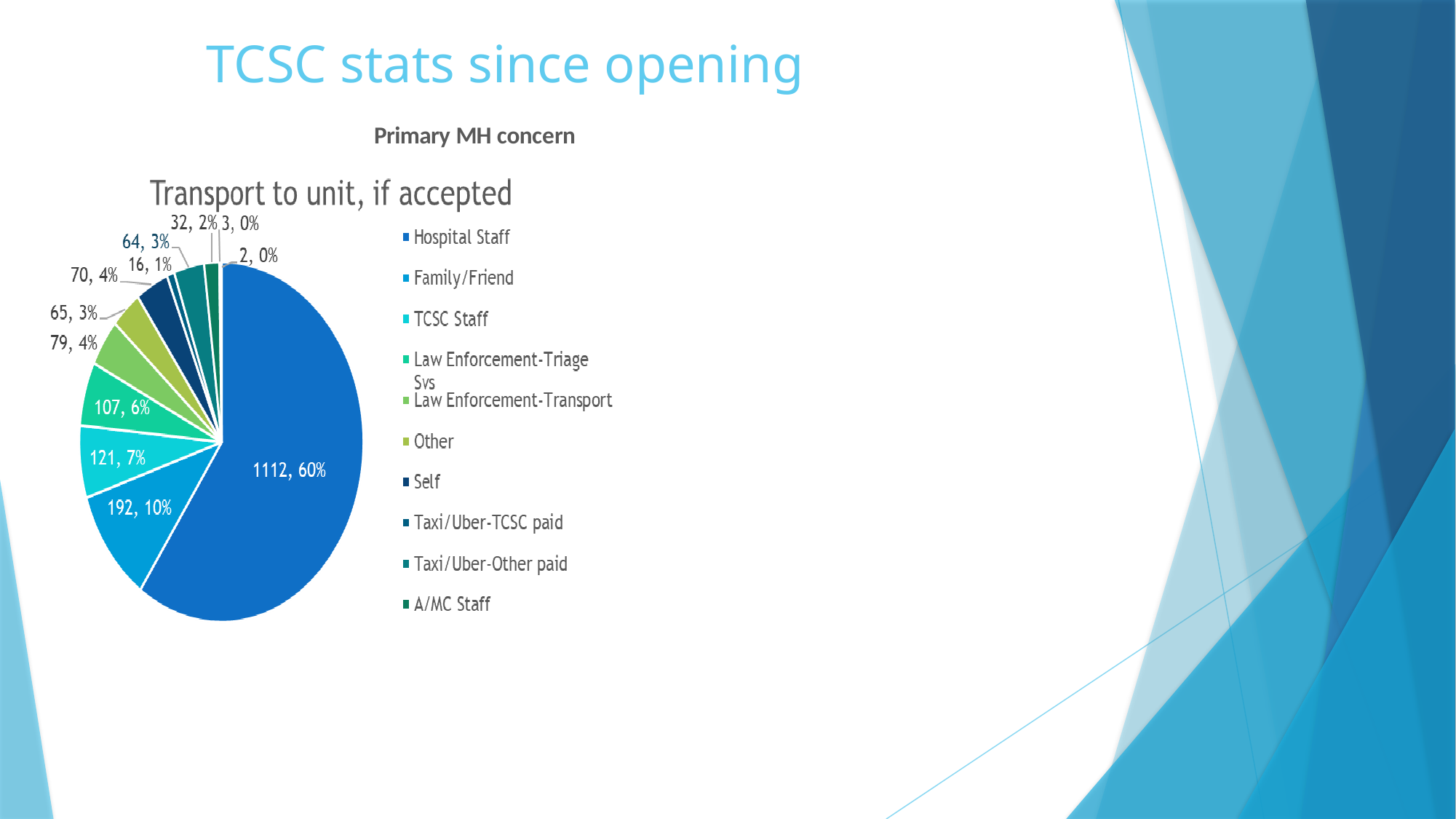
What is the value shown for Family/Friend in the pie chart? 192 Which is larger in the pie chart, Family/Friend or TCSC Staff? Family/Friend What is the difference between the Family/Friend value and the TCSC Staff value? 71 How many entries does the legend of the pie chart list? 10 What share of the pie does Hospital Staff account for? 60% What is the difference between the Hospital Staff value and the Family/Friend value? 920 What is the value shown for Hospital Staff in the pie chart? 1112 What is the value shown for TCSC Staff in the pie chart? 121 What is the title of the pie chart? Transport to unit, if accepted What kind of chart is shown on the slide? pie chart What share of the pie does Family/Friend account for? 10% Which category has the largest slice in the pie chart? Hospital Staff